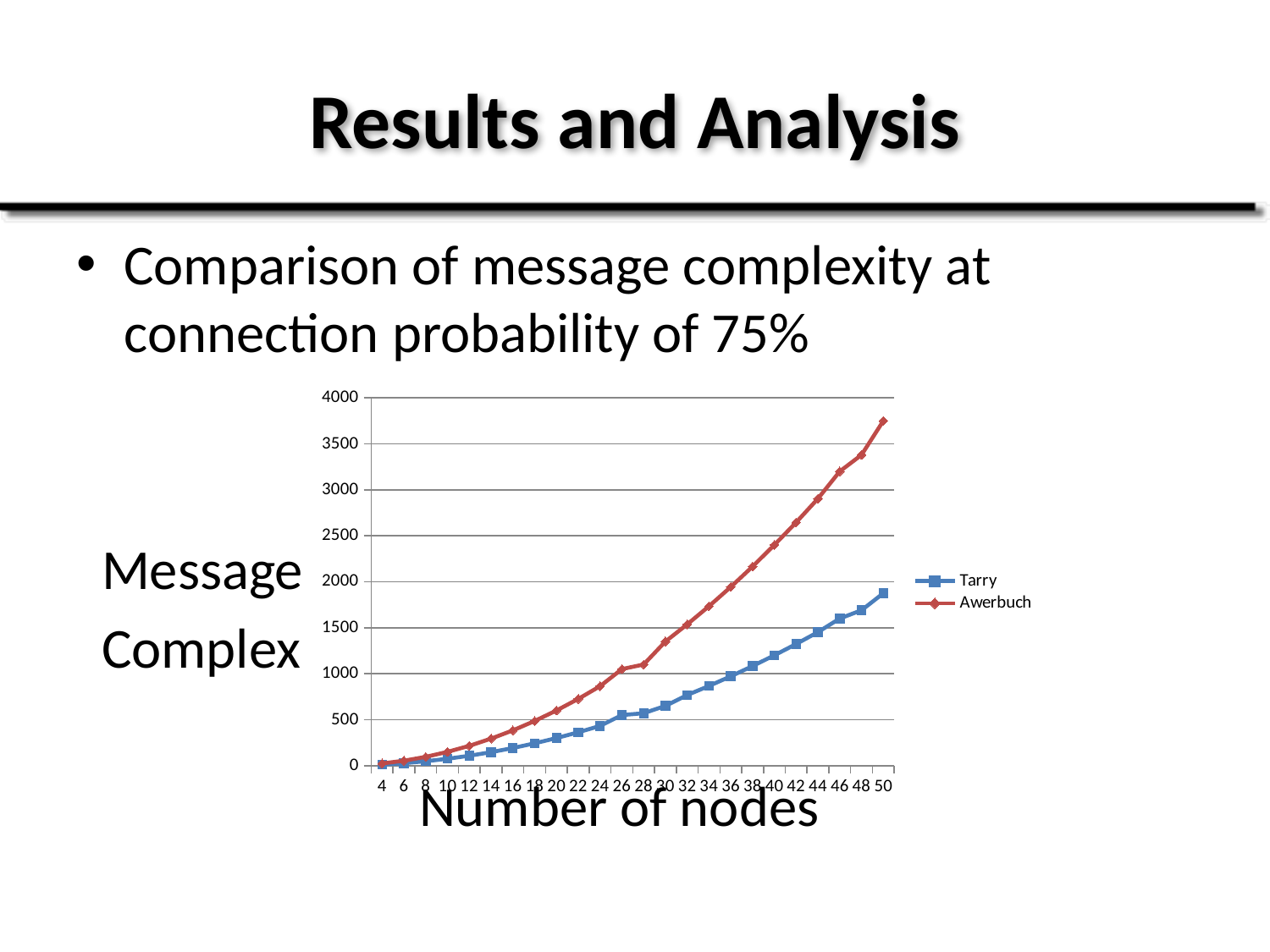
Is the value for Awerbuch at 50 nodes greater or less than 3500? greater At 50 nodes, which series has the larger value, Tarry or Awerbuch? Awerbuch How many data points are plotted along the x axis for each series? 24 What is the label of the x axis? Number of nodes How many series does the legend list? 2 At which number of nodes does the Tarry series have its lowest value? 4 Is the value for Tarry at 50 nodes greater or less than 2000? less What kind of chart is shown on the slide? line chart Do the values for Tarry rise or fall as the number of nodes increases? rise Do the values for Awerbuch rise or fall as the number of nodes increases? rise What are the two series named in the legend? Tarry and Awerbuch At which number of nodes does the Awerbuch series reach its highest value? 50